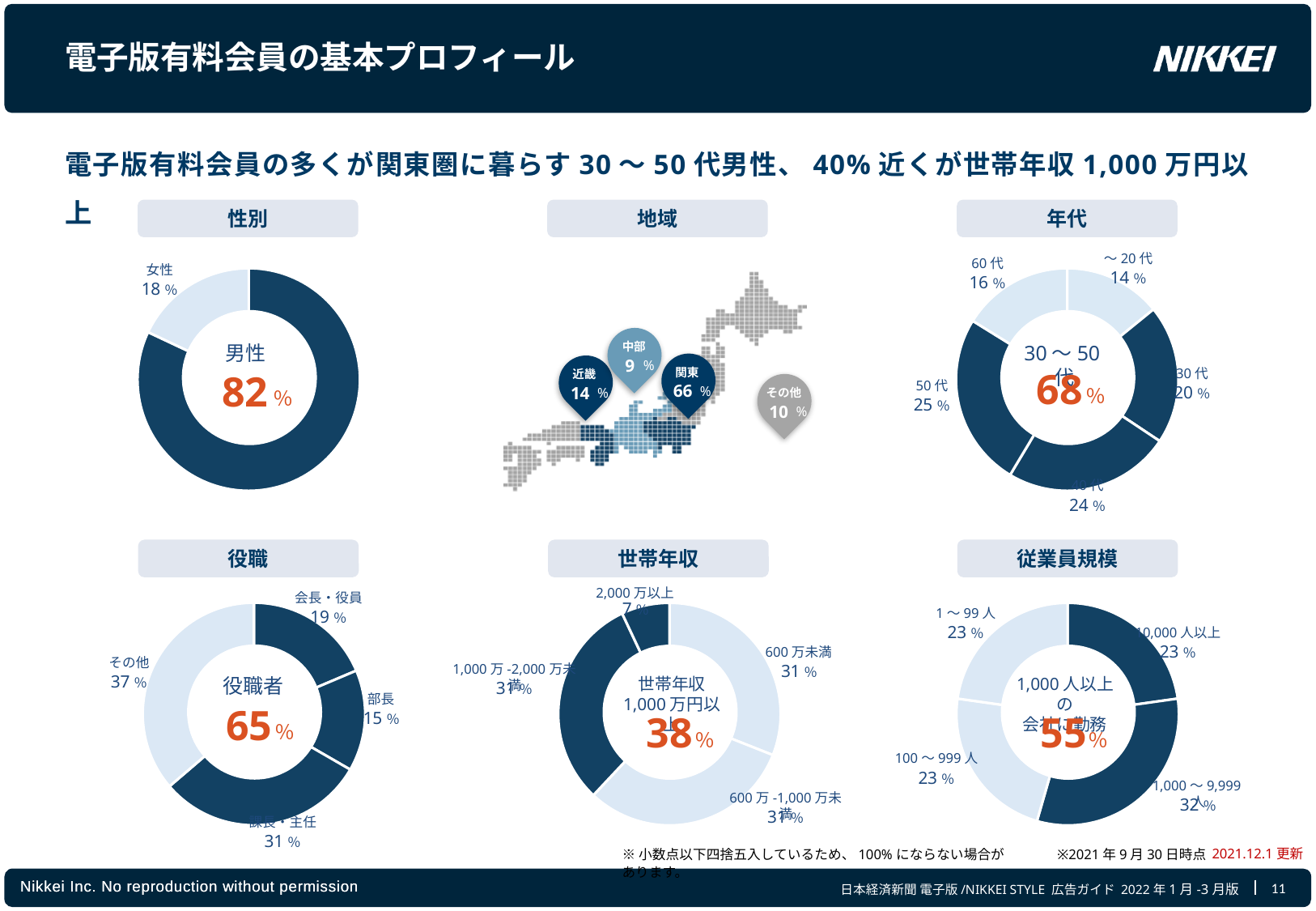
In the 役職 chart, which category has the largest share? その他 In the 性別 chart, what percentage is 女性? 18% In the 地域 map, which region has the lowest share? 中部 In the 従業員規模 chart, what percentage of members work at companies with 1,000～9,999人? 32% In the 性別 chart, what percentage of paid members are 男性? 82% In the 地域 map, what percentage of members live in 関東? 66% In the 役職 chart, which category has the smallest share? 部長 What type of chart is used for the 性別 section? Donut (pie) chart In the 年代 chart, how many age categories are shown? 5 In the 年代 chart, what percentage of members are in their 40代? 24% In the 地域 map, what is the difference between the 関東 share and the 近畿 share? 52% In the 世帯年収 chart, what percentage of members have a household income of 2,000万以上? 7%